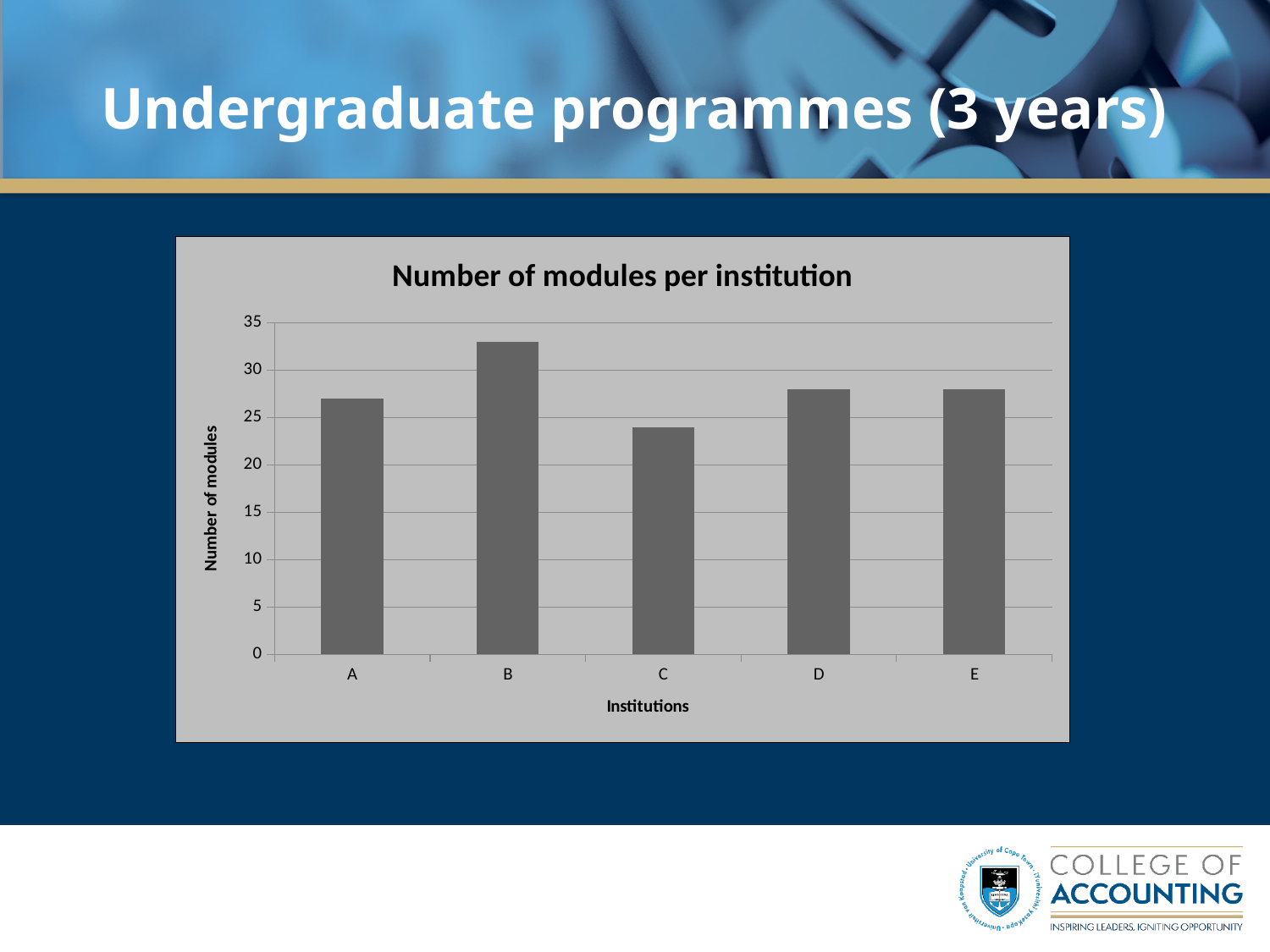
What is the title of the chart? Number of modules per institution Is the number of modules for institution A greater or less than 25? greater Is the number of modules for institution C greater or less than 25? less Which institution has the highest number of modules? B Which institution has the lowest number of modules? C What kind of chart is shown on the slide? bar chart Which has more modules, institution C or institution D? D What is the label of the y axis of the chart? Number of modules Which has more modules, institution B or institution A? B Is the number of modules for institution B greater or less than 30? greater How many institutions are shown on the x axis of the chart? 5